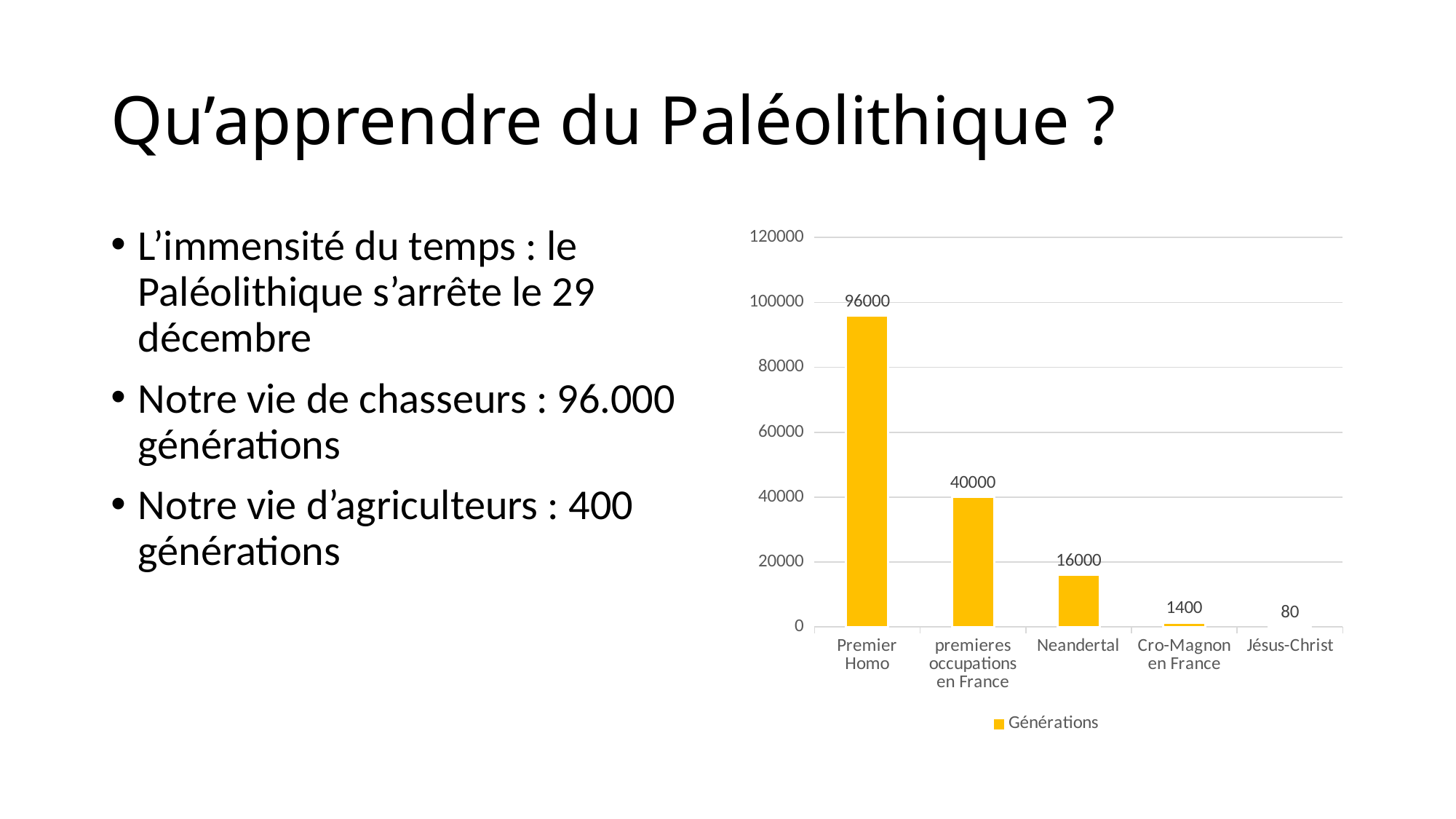
What is the difference between the values for Premier Homo and premieres occupations en France? 56000 Which category has the highest value? Premier Homo Which category has the lowest value? Jésus-Christ What is the value for Jésus-Christ? 80 How many categories are shown on the x axis? 5 How many series does the legend list? 1 Which is larger, the value for Neandertal or the value for Cro-Magnon en France? Neandertal What is the value for Premier Homo? 96000 Do the values rise or fall from left to right along the x axis? fall What is the value for Neandertal? 16000 What kind of chart is shown? bar chart What is the value for Cro-Magnon en France? 1400